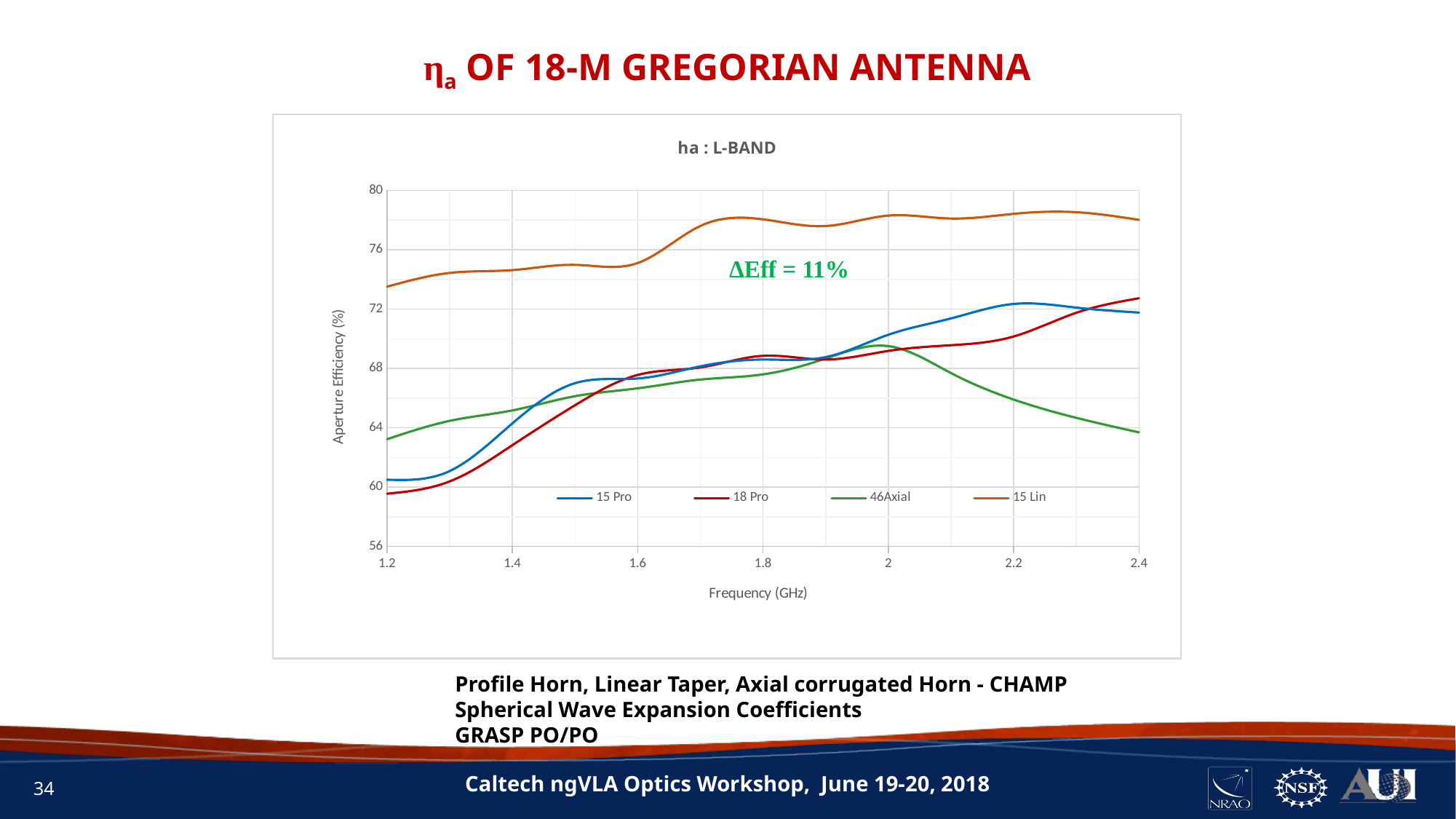
Is the value for 46Axial at 2.4 GHz greater or less than 68? less What is the label of the y axis? Aperture Efficiency (%) Which series has the lowest aperture efficiency at 2.4 GHz? 46Axial What kind of chart is shown on the slide? line chart Is the value for 15 Lin at 2 GHz greater or less than 76? greater At 2 GHz, which series has the larger aperture efficiency, 15 Lin or 46Axial? 15 Lin How many series does the legend list? 4 What is the title shown inside the chart area? ha : L-BAND Which series has the highest aperture efficiency across the whole frequency range? 15 Lin Is the value for 15 Pro at 2.2 GHz greater or less than 68? greater Does the 18 Pro series rise or fall as frequency increases from 1.2 to 2.4 GHz? rise